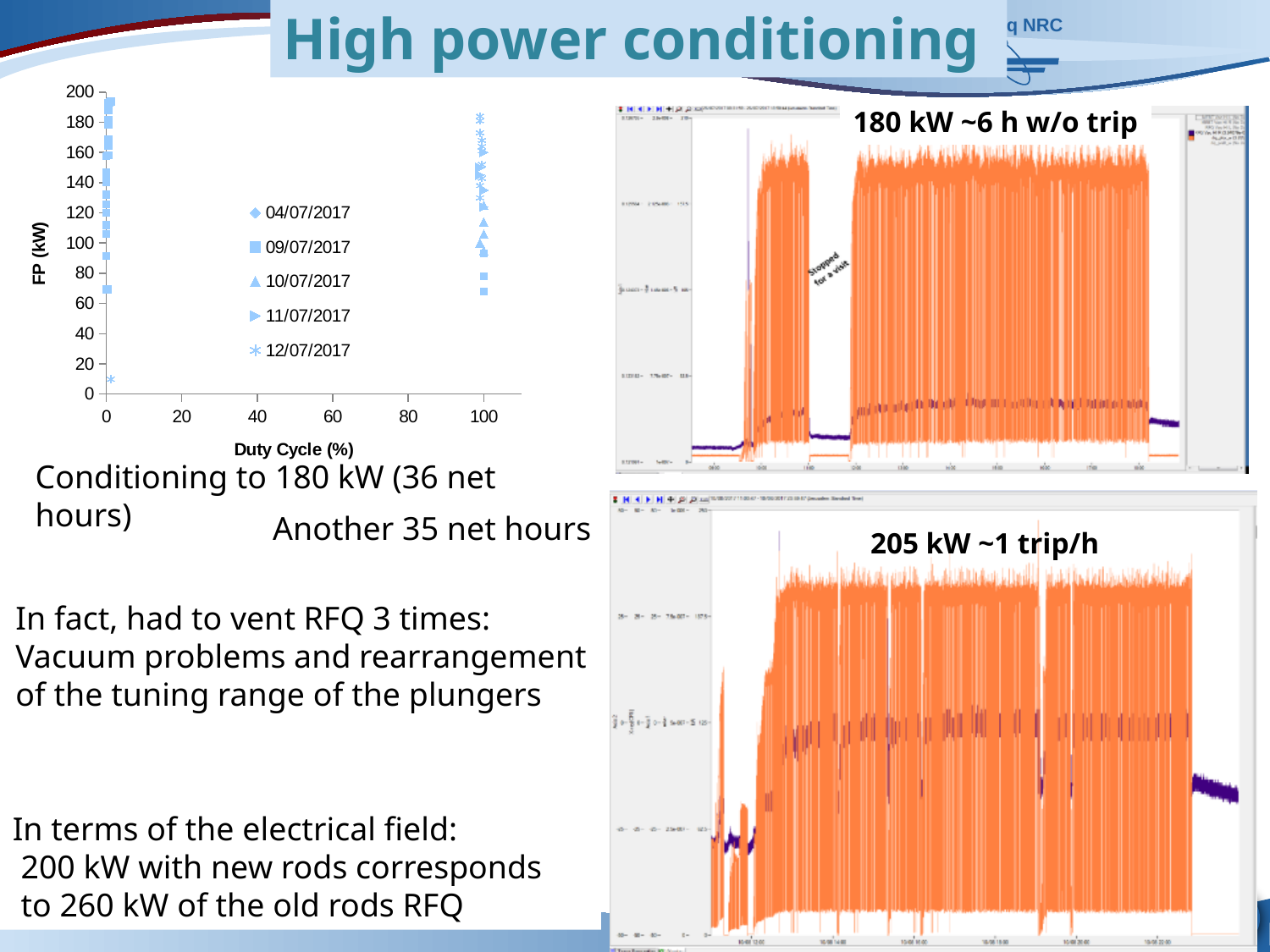
On the left chart, is the highest FP value for the 12/07/2017 series greater or less than 100? greater What is the label of the x axis on the left chart? Duty Cycle (%) On the left chart, which legend entry is represented by asterisk markers? 12/07/2017 On the left chart, are the 10/07/2017 points at 100% duty cycle greater or less than 60 kW? greater On the left chart, is the lowest FP value for the 12/07/2017 series (at duty cycle 0) greater or less than 20? less How many series does the legend of the left chart list? 5 What kind of chart is shown on the left of the slide? scatter chart What is the maximum value shown on the y axis of the left chart? 200 On the left chart, which series reaches higher FP values at 100% duty cycle: 12/07/2017 or 10/07/2017? 12/07/2017